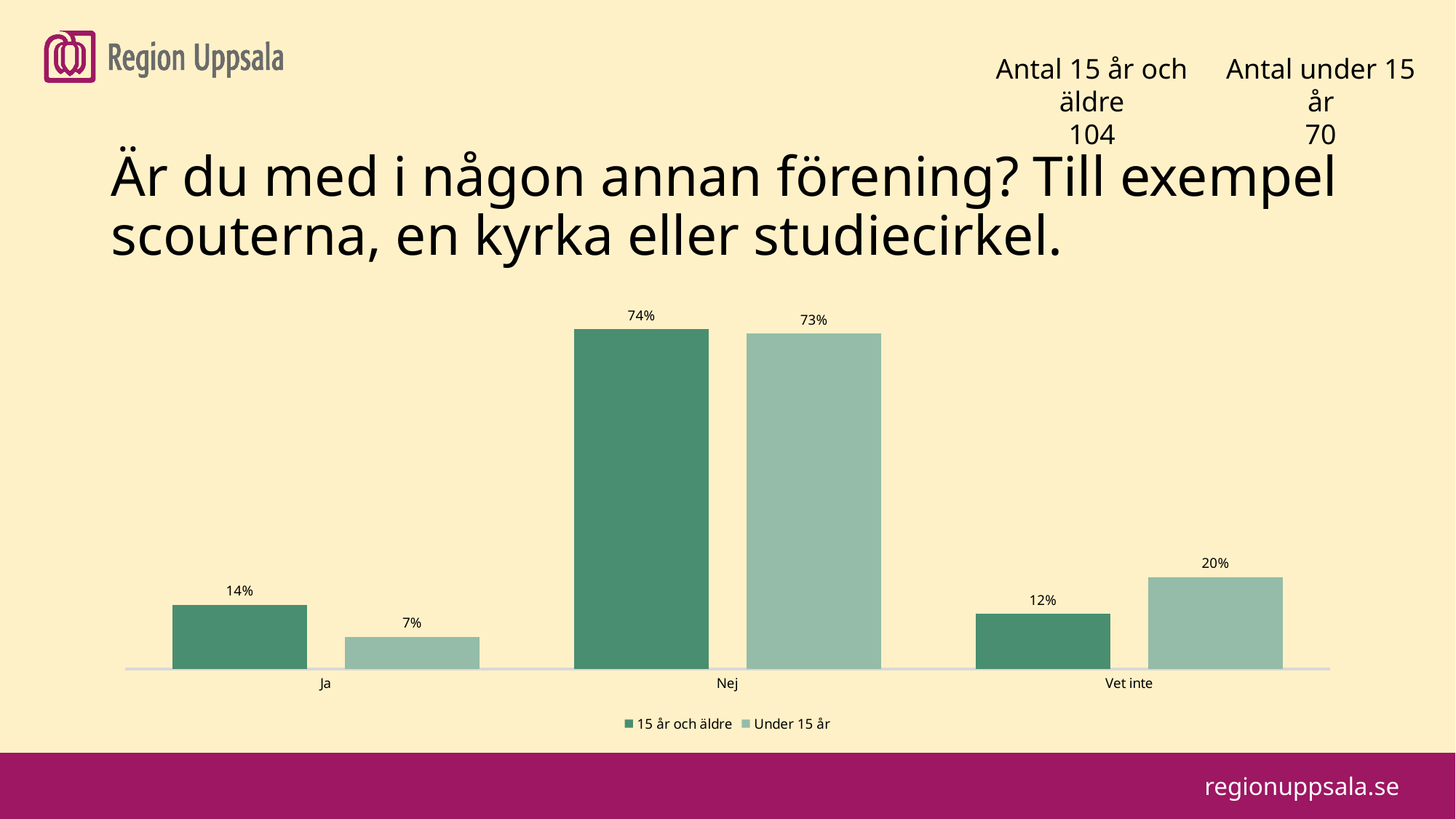
What is the value for "Vet inte" in the "Under 15 år" series? 20% What kind of chart is shown on the slide? Bar chart For "Ja", which series has the larger value: "15 år och äldre" or "Under 15 år"? 15 år och äldre What is the difference between the "Under 15 år" and "15 år och äldre" values for "Vet inte"? 8% How many categories are shown on the x axis? 3 What is the value for "Ja" in the "15 år och äldre" series? 14% Which category has the lowest value in the "Under 15 år" series? Ja What are the two series names listed in the legend? 15 år och äldre, Under 15 år What is the value for "Nej" in the "Under 15 år" series? 73% Which category has the highest value in the "15 år och äldre" series? Nej What is the value for "Ja" in the "Under 15 år" series? 7% How many series does the legend list? 2